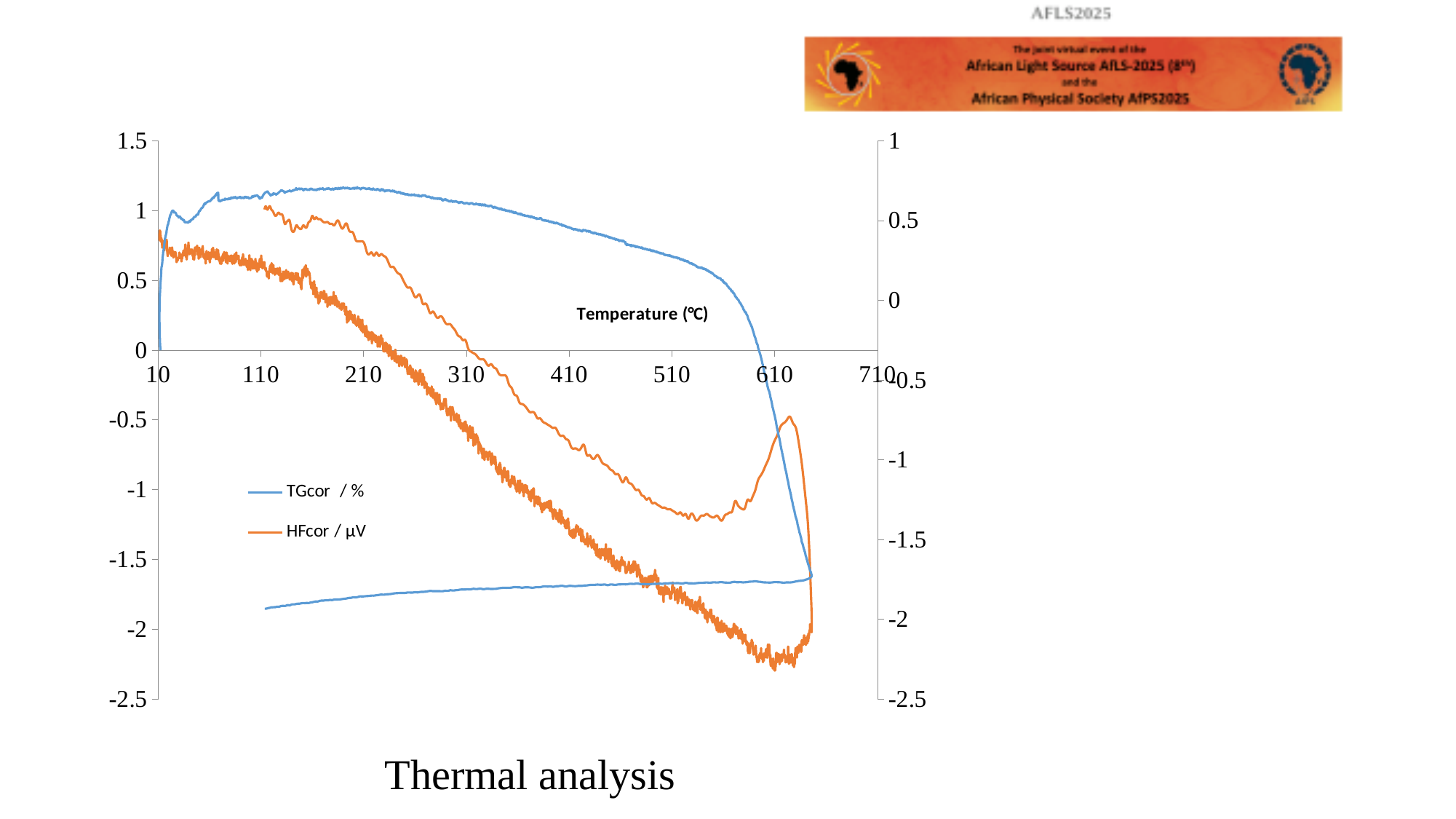
Along the upper TGcor curve, does the value rise or fall as temperature increases from 210 to 610 °C? fall Is the highest value reached by the TGcor curve greater or less than 1 on the left axis? greater How many series does the legend list? 2 What are the two series named in the legend? TGcor / % and HFcor / µV What kind of chart is shown on the slide? line chart Is the value of the upper TGcor curve at 510 °C greater or less than 0.5 on the left axis? greater What is the title written below the chart? Thermal analysis Is the lowest value reached by the TGcor curve greater or less than -1.5 on the left axis? less